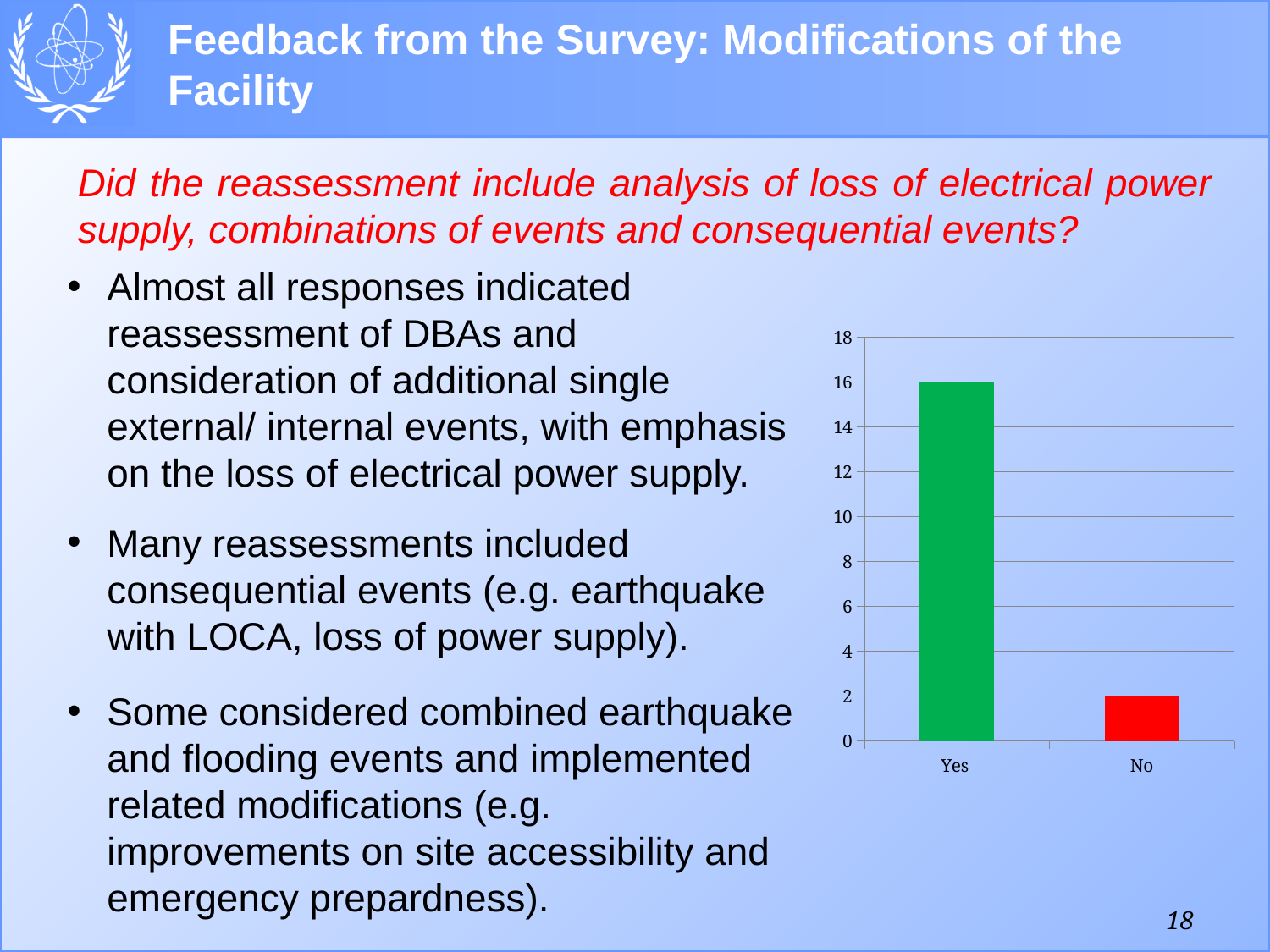
What is the difference between the values for Yes and No? 14 What kind of chart is shown on the slide? bar chart What is the value for No in the chart? 2 Which category has the highest value in the chart? Yes Is the value for No greater or less than 4? less Which category has the lowest value in the chart? No What is the highest value shown on the y axis of the chart? 18 Is the value for Yes greater or less than 10? greater What is the value for Yes in the chart? 16 What colour is the bar for Yes? green How many categories are shown on the x axis of the chart? 2 Which is larger, the value for Yes or the value for No? Yes